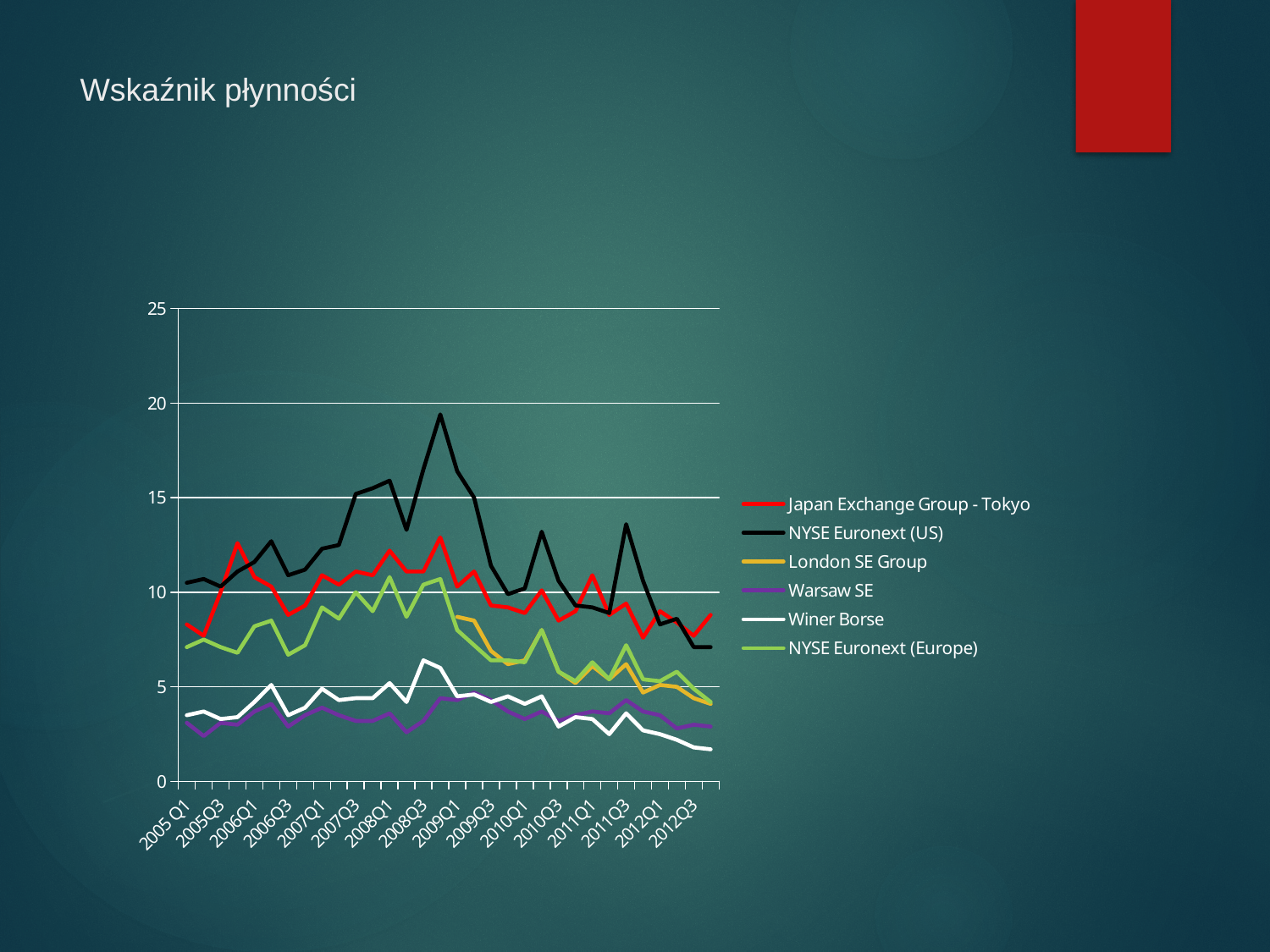
What is the title of the slide containing the chart? Wskaźnik płynności Is the value for Winer Borse at 2012Q3 greater or less than 5? less How many labels are shown on the x axis? 16 Is the value for NYSE Euronext (US) at 2009Q1 greater or less than 15? greater Which colour is used for the Japan Exchange Group - Tokyo line? red Which series has the lowest value at 2012Q3? Winer Borse How many series does the legend list? 6 At 2009Q1, which is larger: NYSE Euronext (US) or Japan Exchange Group - Tokyo? NYSE Euronext (US) Which series reaches the highest value anywhere on the chart? NYSE Euronext (US) What kind of chart is shown on the slide? line chart Does the NYSE Euronext (US) line rise or fall from 2009Q1 to 2012Q3? fall